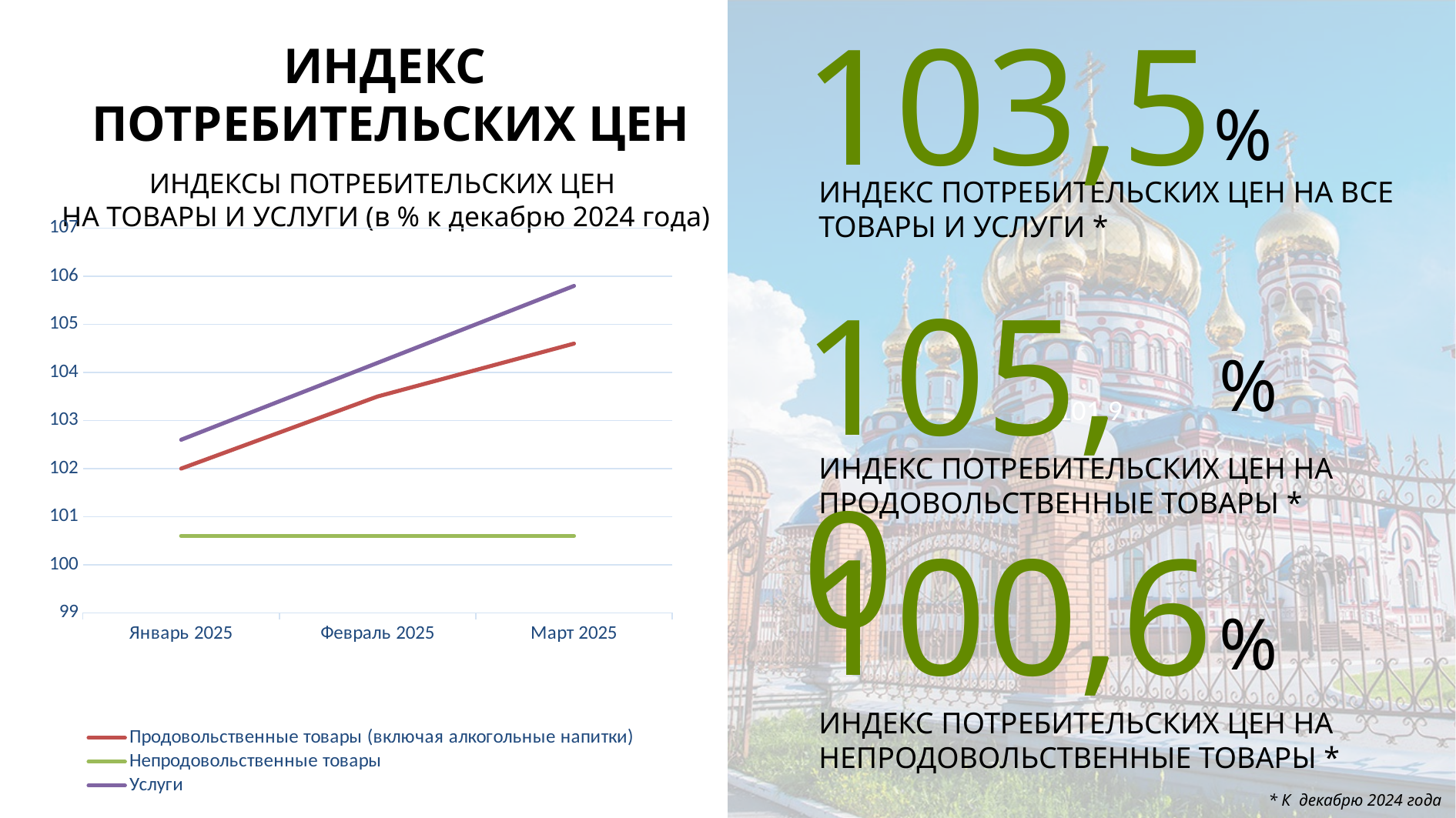
In Март 2025, which is larger: the value for Услуги or the value for Продовольственные товары (включая алкогольные напитки)? Услуги Is the value for Продовольственные товары (включая алкогольные напитки) in Март 2025 greater or less than 104? greater Is the value for Непродовольственные товары in Март 2025 greater or less than 101? less How many time points are plotted along the x axis of the chart? 3 Is the value for Услуги in Март 2025 greater or less than 105? greater How many series does the chart legend list? 3 What kind of chart is shown on the slide? line chart Does the Продовольственные товары (включая алкогольные напитки) line rise or fall from Январь 2025 to Март 2025? rise What colour is the Услуги line in the chart? purple Does the Услуги line rise or fall from Январь 2025 to Март 2025? rise Which series has the lowest value in Январь 2025? Непродовольственные товары